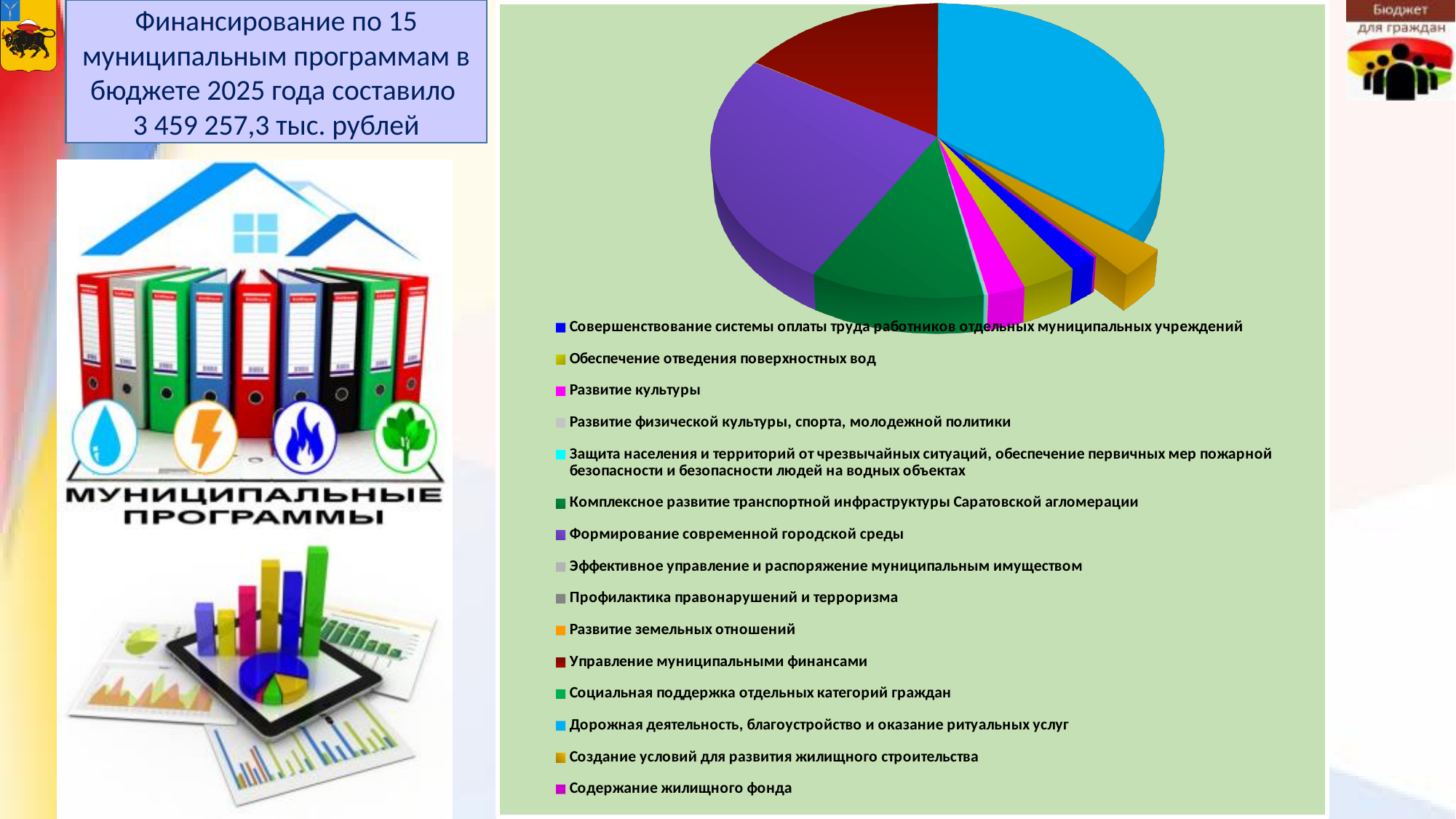
Which slice is larger: Формирование современной городской среды or Комплексное развитие транспортной инфраструктуры Саратовской агломерации? Формирование современной городской среды Which slice is larger: Дорожная деятельность, благоустройство и оказание ритуальных услуг or Формирование современной городской среды? Дорожная деятельность, благоустройство и оказание ритуальных услуг Which slice is larger: Управление муниципальными финансами or Развитие культуры? Управление муниципальными финансами According to the text box on the slide, what was the total financing of the 15 municipal programmes in the 2025 budget? 3 459 257,3 тыс. рублей How many entries does the legend of the pie chart list? 15 What colour is the slice for Формирование современной городской среды in the pie chart? purple Which municipal programme has the largest slice of the pie chart? Дорожная деятельность, благоустройство и оказание ритуальных услуг What kind of chart is shown on the slide? pie chart